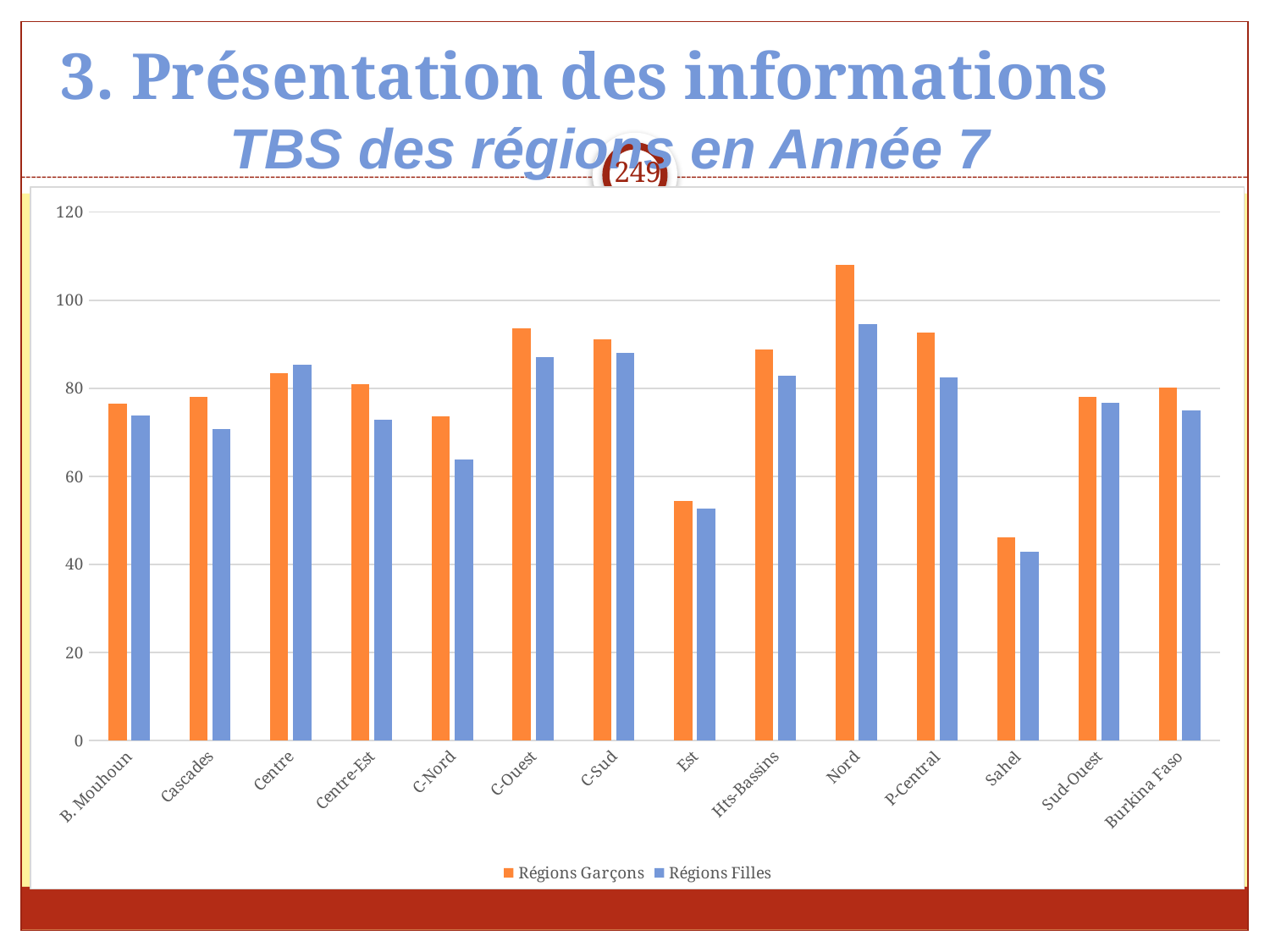
Is the Régions Garçons value for Est greater or less than 60? less Which region has the lowest value for Régions Garçons? Sahel Is the Régions Filles value for Cascades greater or less than 80? less How many series does the legend list? 2 What is the title of the chart? TBS des régions en Année 7 Which region has the lowest value for Régions Filles? Sahel For C-Nord, which is larger: Régions Garçons or Régions Filles? Régions Garçons Which region has the highest value for Régions Garçons? Nord How many regions (categories) are shown on the x axis? 14 Is the Régions Garçons value for Nord greater or less than 100? greater Which colour represents Régions Filles in the chart? blue What kind of chart is shown on the slide? bar chart